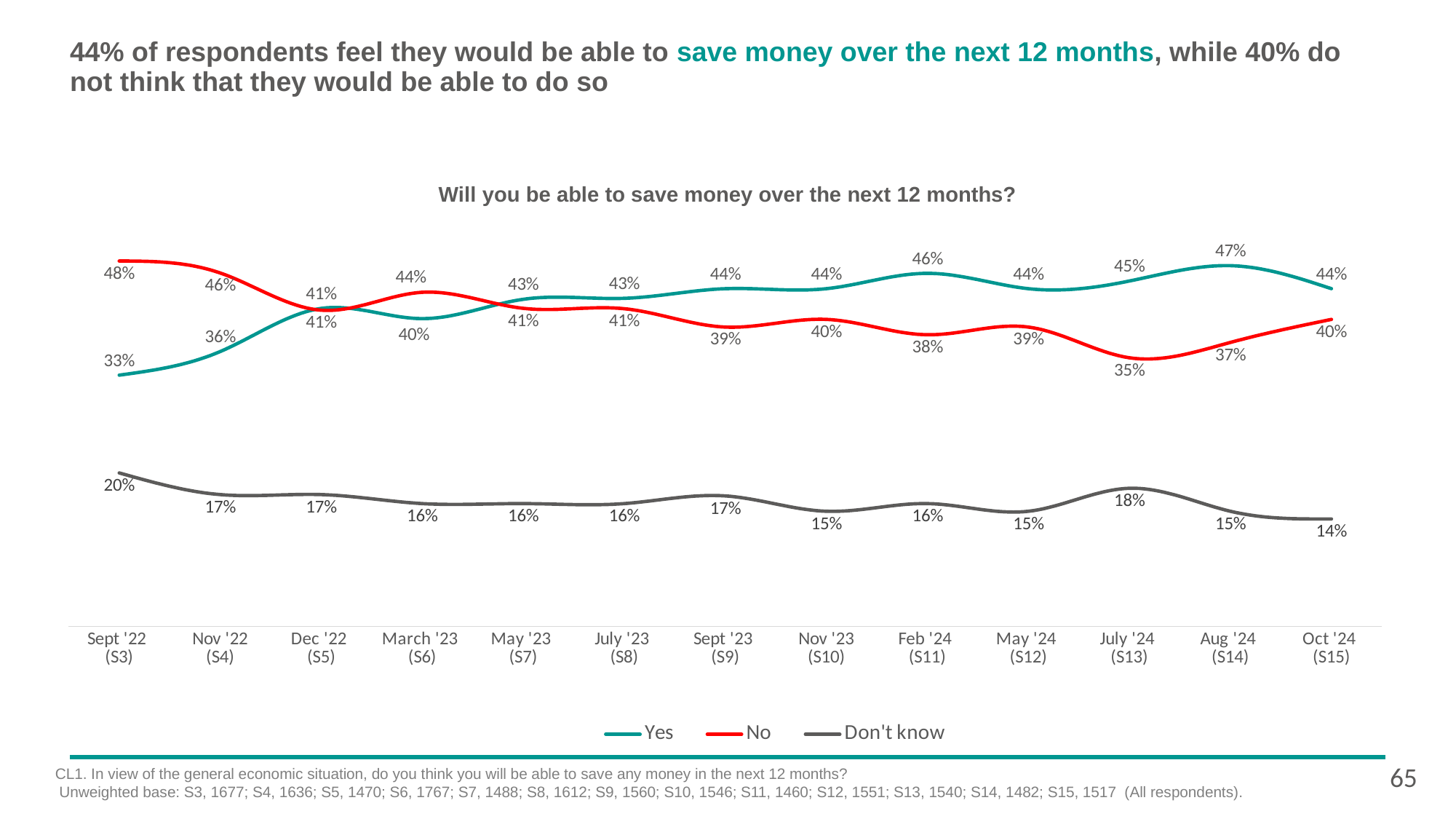
What is the title of the chart? Will you be able to save money over the next 12 months? What is the value for Don't know in Sept '22 (S3)? 20% In which period does the Yes series reach its highest value? Aug '24 (S14) In which period is the No series at its lowest value? July '24 (S13) What is the difference between the No and Yes values in Sept '22 (S3)? 15% How many time periods are shown on the x axis? 13 What kind of chart is this? Line chart Does the Yes series rise or fall between Sept '22 (S3) and Dec '22 (S5)? Rise What is the value for No in July '24 (S13)? 35% Which is larger in Feb '24 (S11), Yes or No? Yes How many series does the legend list? 3 What is the value for Yes in Oct '24 (S15)? 44%